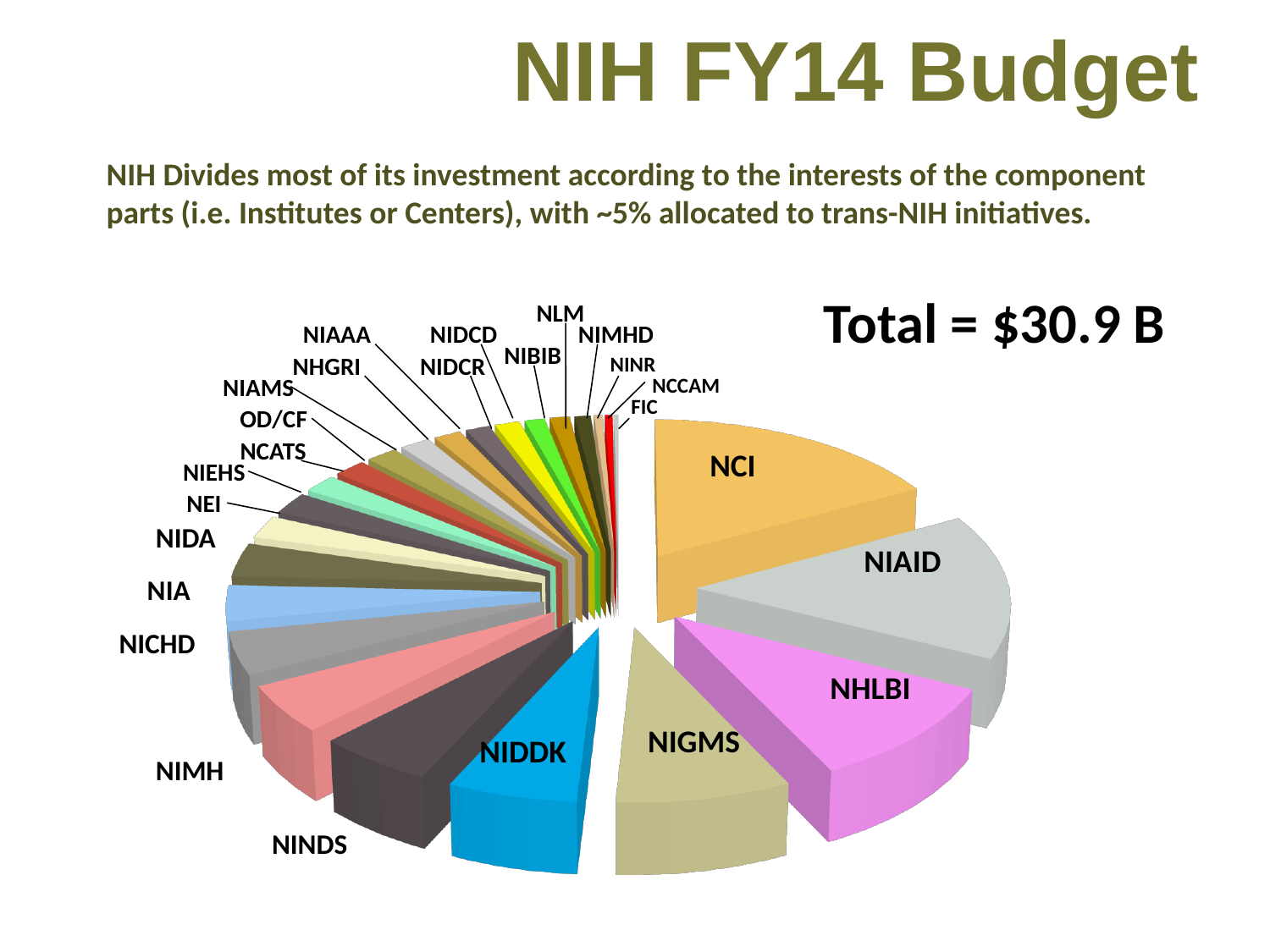
Which slice is larger, FIC or NIGMS? NIGMS Which institute has the largest slice of the pie chart? NCI Which slice is larger, NHLBI or NEI? NHLBI Which slice is larger, NIDDK or NIBIB? NIDDK How many slices (institutes/centers) does the pie chart show? 25 What is the title of the slide containing the pie chart? NIH FY14 Budget What kind of chart is shown on the slide? pie chart What total budget is stated next to the pie chart? $30.9 B